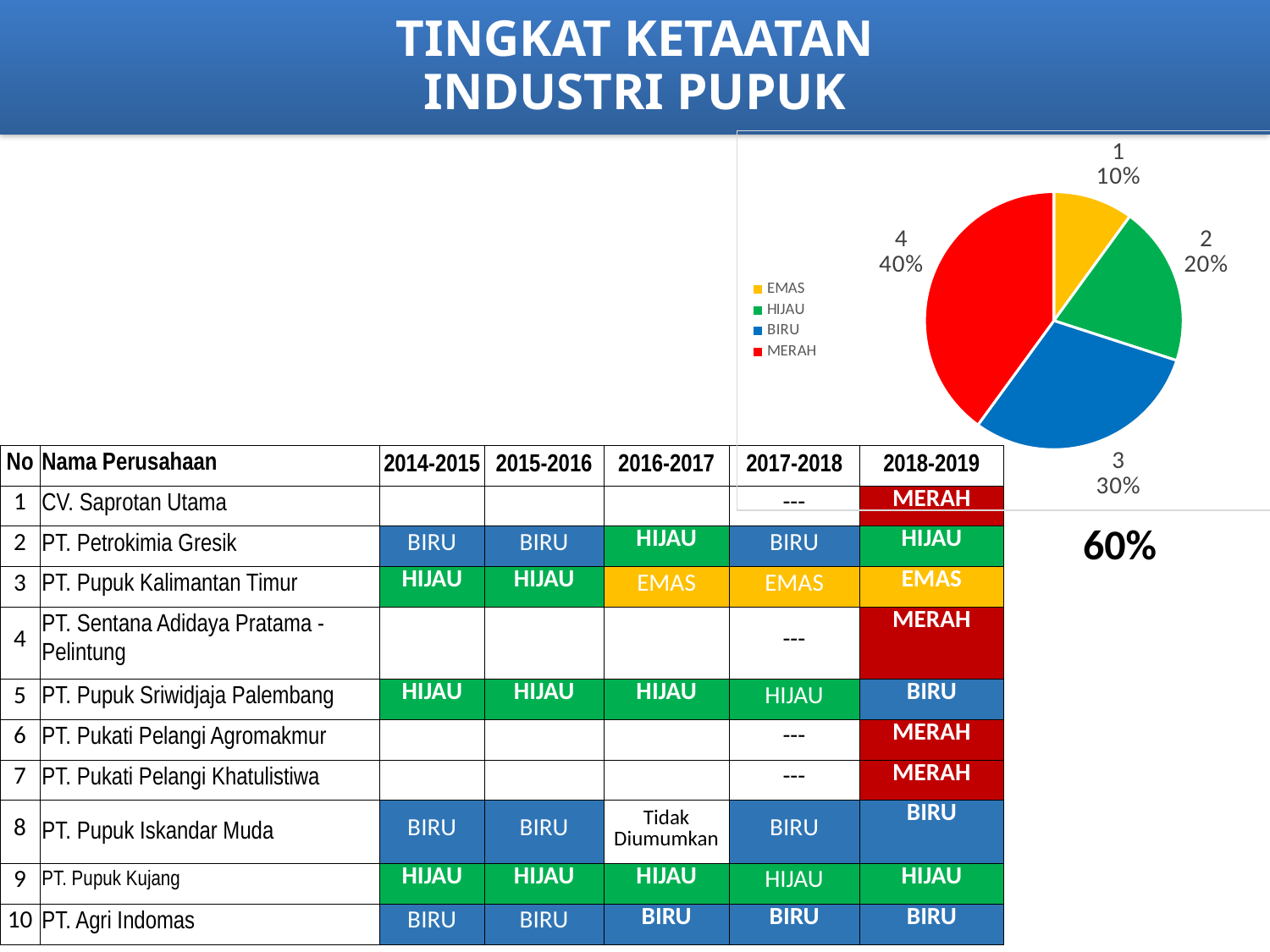
What percentage of the pie chart does the HIJAU slice represent? 20% What percentage of the pie chart does the EMAS slice represent? 10% What percentage of the pie chart does the MERAH slice represent? 40% What colour is the MERAH slice in the pie chart? red In the pie chart, which slice is larger, BIRU or HIJAU? BIRU Which category has the smallest slice in the pie chart? EMAS What kind of chart is shown on the slide? pie chart How many entries does the pie chart's legend list? 4 How many slices does the pie chart have? 4 What is the difference in percentage points between the MERAH slice and the EMAS slice in the pie chart? 30% Which category has the largest slice in the pie chart? MERAH